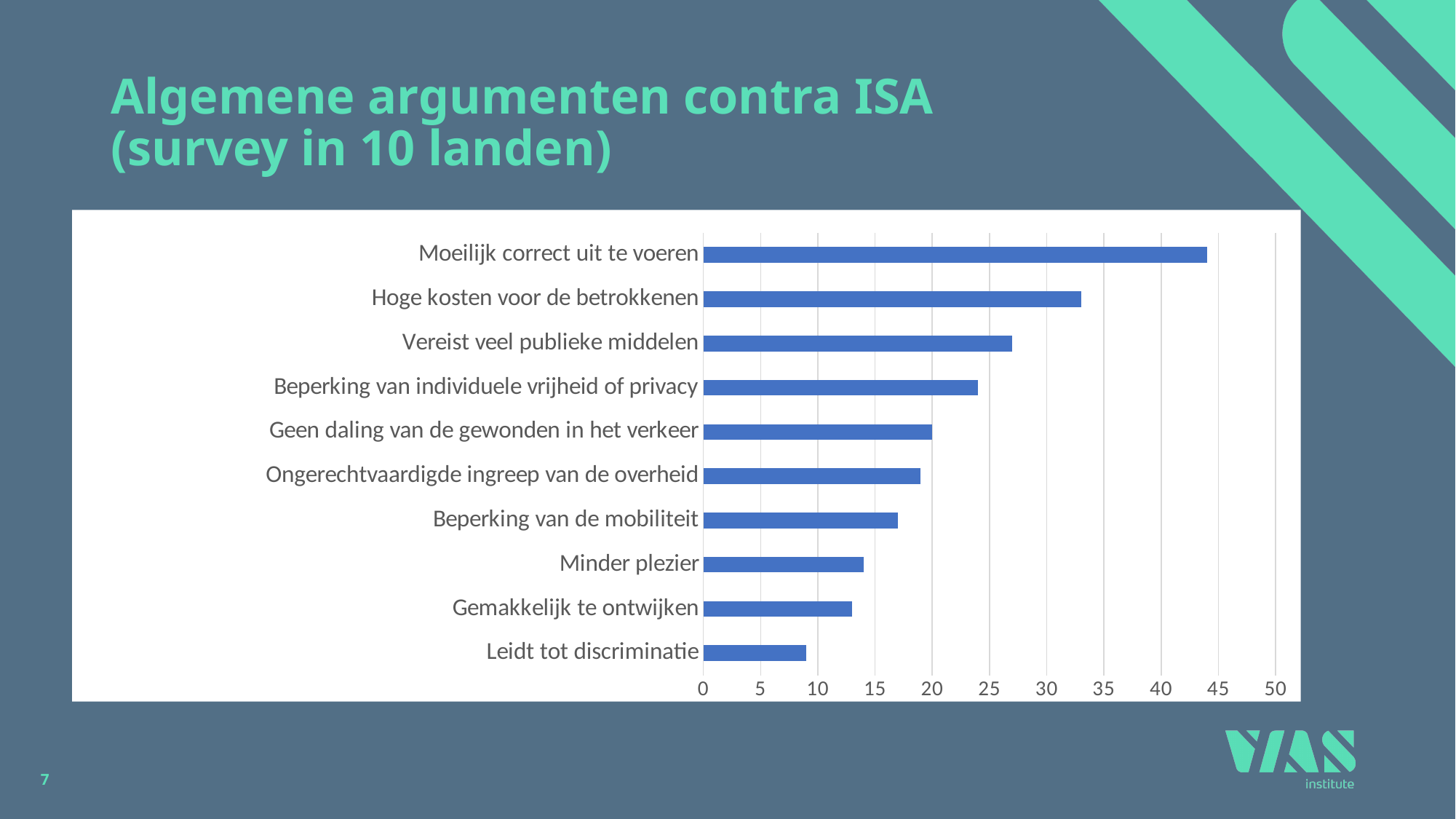
Is the value for 'Moeilijk correct uit te voeren' greater or less than 40? greater What kind of chart is shown on the slide? bar chart Which is larger: the value for 'Beperking van individuele vrijheid of privacy' or the value for 'Hoge kosten voor de betrokkenen'? Hoge kosten voor de betrokkenen Is the value for 'Leidt tot discriminatie' greater or less than 10? less Is the value for 'Vereist veel publieke middelen' greater or less than 25? greater Which argument has the lowest value in the chart? Leidt tot discriminatie How many categories (arguments) are plotted in the chart? 10 Which is larger: the value for 'Beperking van de mobiliteit' or the value for 'Gemakkelijk te ontwijken'? Beperking van de mobiliteit What is the title of the slide containing the chart? Algemene argumenten contra ISA (survey in 10 landen) Which argument has the highest value in the chart? Moeilijk correct uit te voeren